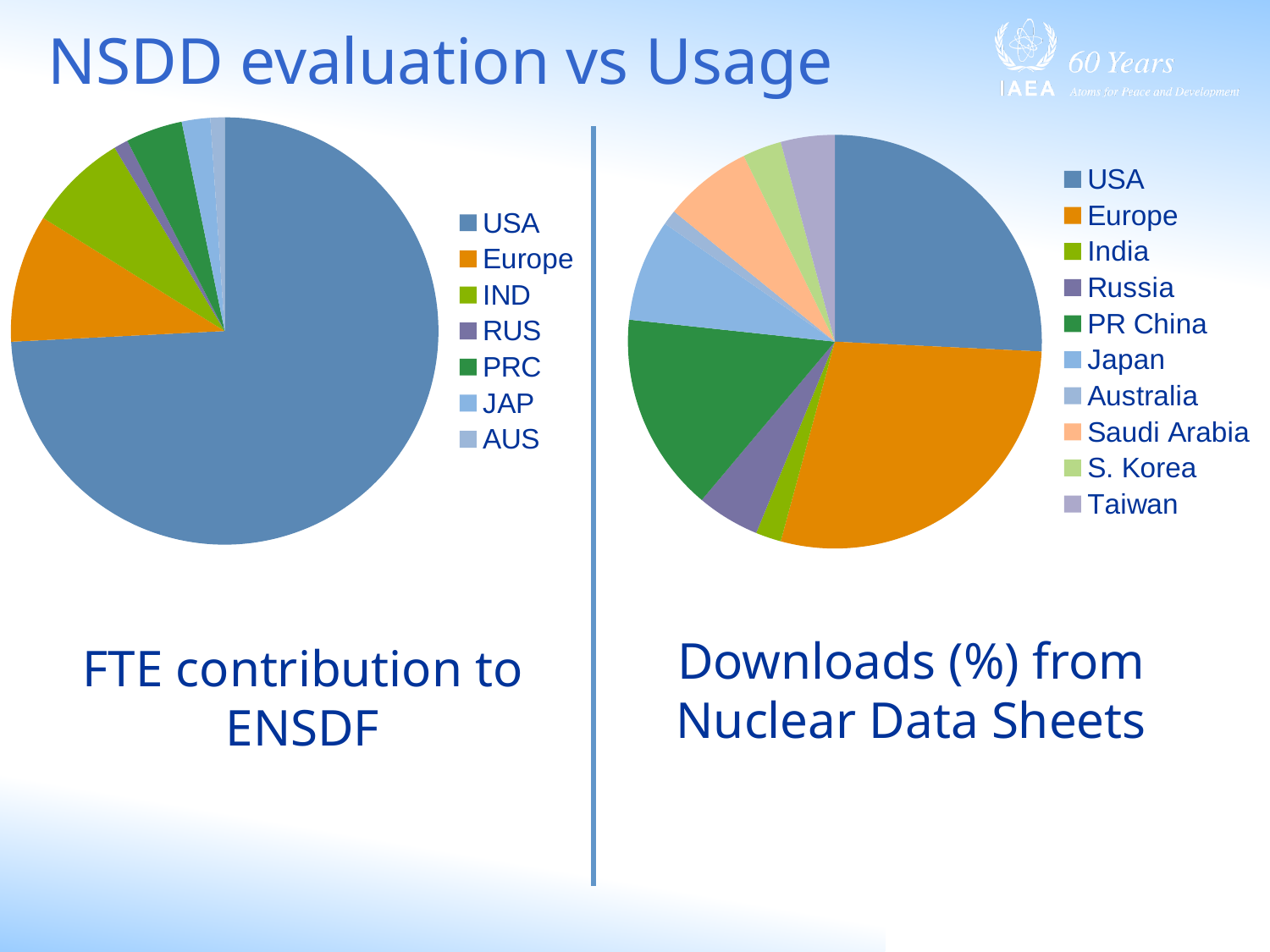
What kind of chart is the 'FTE contribution to ENSDF' chart on the left? pie chart In the 'Downloads (%) from Nuclear Data Sheets' chart on the right, which category is listed last in the legend? Taiwan In the 'FTE contribution to ENSDF' chart on the left, which slice is larger, USA or Europe? USA What is the caption under the pie chart on the left? FTE contribution to ENSDF In the 'FTE contribution to ENSDF' chart on the left, which slice is larger, Europe or IND? Europe In the 'Downloads (%) from Nuclear Data Sheets' chart on the right, which slice is larger, PR China or India? PR China In the 'Downloads (%) from Nuclear Data Sheets' chart on the right, how many categories does the legend list? 10 In the 'FTE contribution to ENSDF' chart on the left, which category has the largest slice? USA What kind of chart is the 'Downloads (%) from Nuclear Data Sheets' chart on the right? pie chart In the 'FTE contribution to ENSDF' chart on the left, how many categories does the legend list? 7